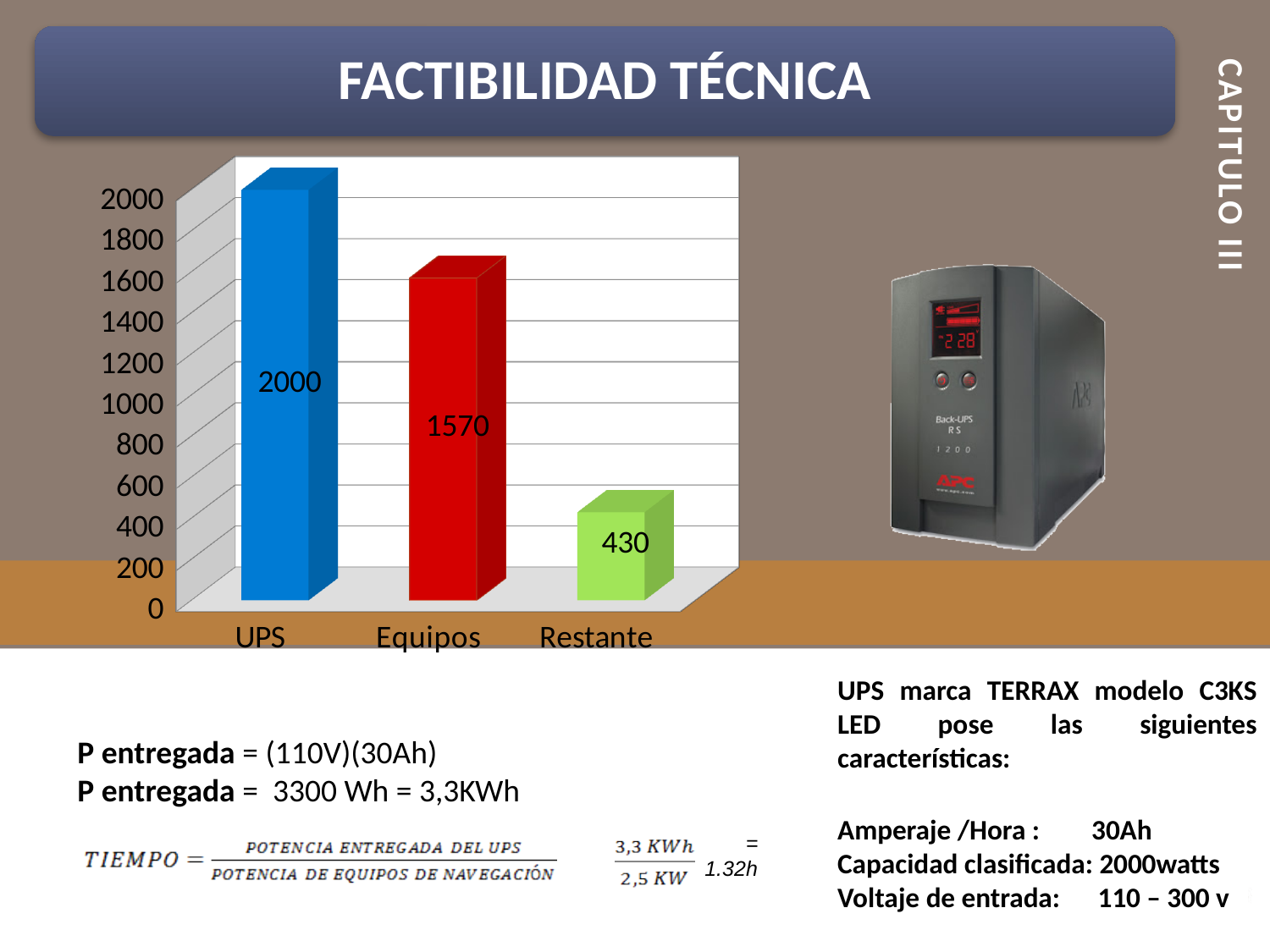
Which is larger, the value for Equipos or the value for Restante? Equipos What is the value for Restante in the bar chart? 430 What is the difference between the values for UPS and Equipos? 430 What is the value for UPS in the bar chart? 2000 What is the difference between the values for Equipos and Restante? 1140 Which category has the lowest value in the bar chart? Restante Which category has the highest value in the bar chart? UPS Is the value for Equipos greater or less than 1400? greater How many categories are shown in the bar chart? 3 What kind of chart is shown on the slide? bar chart What is the value for Equipos in the bar chart? 1570 What colour is the bar for Restante? green